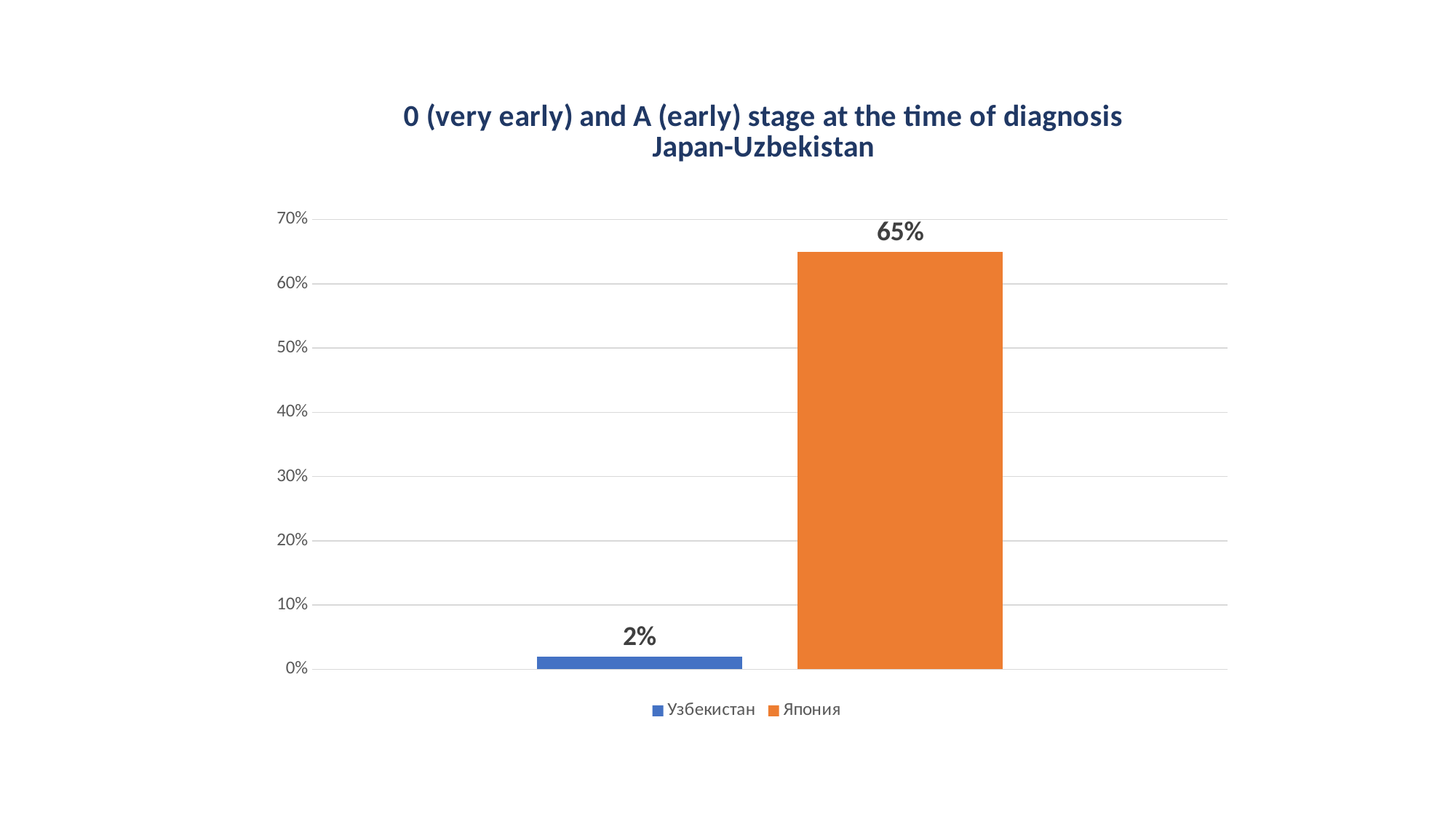
What is the title of the chart? 0 (very early) and A (early) stage at the time of diagnosis Japan-Uzbekistan How many series does the legend list? 2 What is the difference between the values for Япония and Узбекистан? 63% What kind of chart is shown on the slide? bar chart Which series has the lowest value? Узбекистан What is the value for Япония? 65% Which is larger, the value for Япония or the value for Узбекистан? Япония Is the value for Узбекистан greater or less than 10%? less What colour is the bar for Япония? orange Which series has the highest value? Япония What is the value for Узбекистан? 2% Is the value for Япония greater or less than 60%? greater